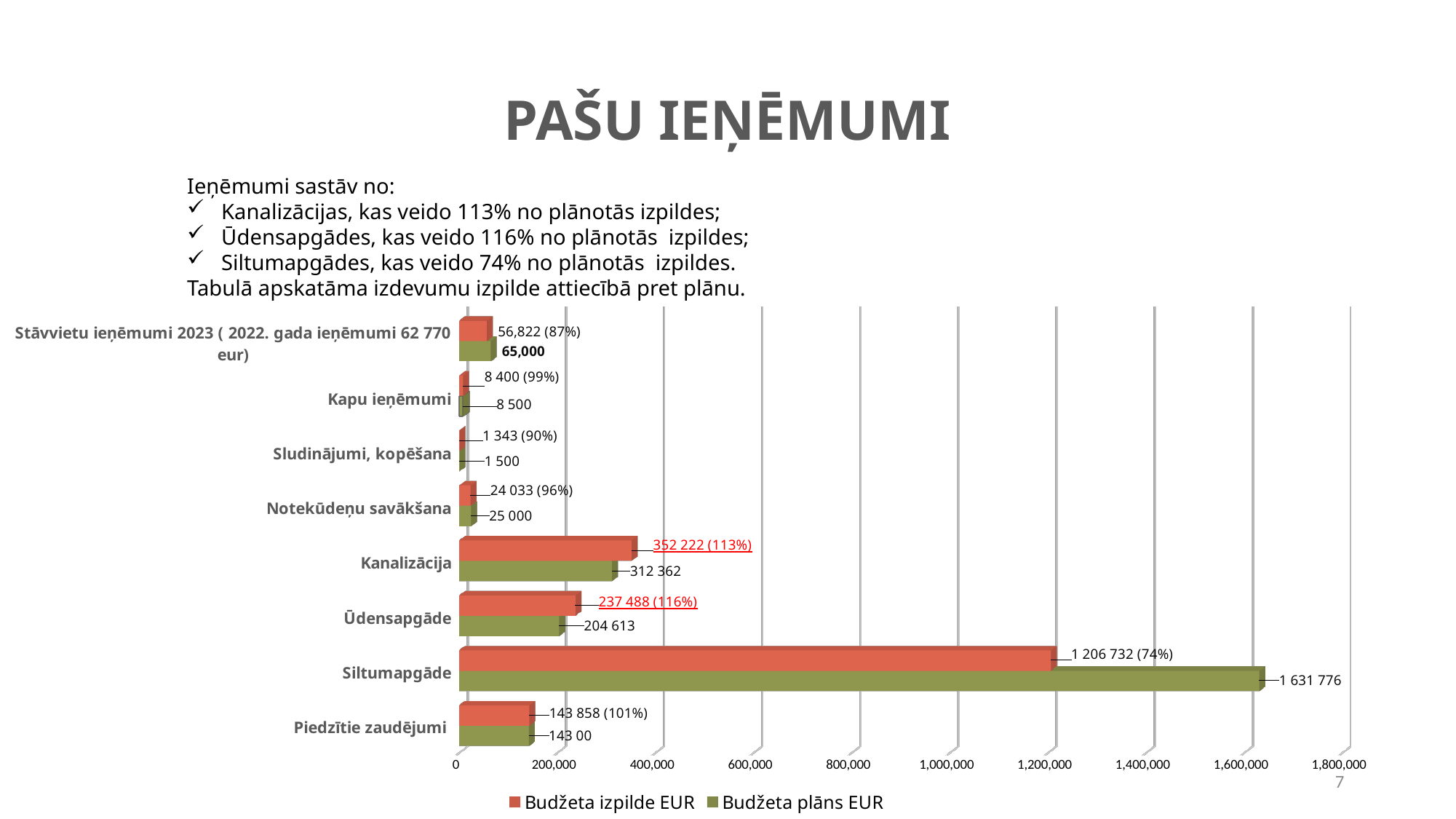
For Ūdensapgāde, which is larger: Budžeta izpilde EUR or Budžeta plāns EUR? Budžeta izpilde EUR What is the Budžeta plāns EUR value for Ūdensapgāde? 204 613 What is the Budžeta plāns EUR value for Siltumapgāde? 1 631 776 What is the Budžeta izpilde EUR value for Kanalizācija? 352 222 (113%) For Siltumapgāde, what is the difference between the Budžeta plāns EUR value and the Budžeta izpilde EUR value? 425 044 What is the Budžeta izpilde EUR value for Kapu ieņēmumi? 8 400 (99%) What kind of chart is shown on the slide? bar chart Which category has the lowest Budžeta izpilde EUR value? Sludinājumi, kopēšana How many categories are shown on the chart? 8 How many series does the chart legend list? 2 Is the Budžeta izpilde EUR value for Siltumapgāde greater or less than 1,000,000? greater Which category has the highest Budžeta plāns EUR value? Siltumapgāde